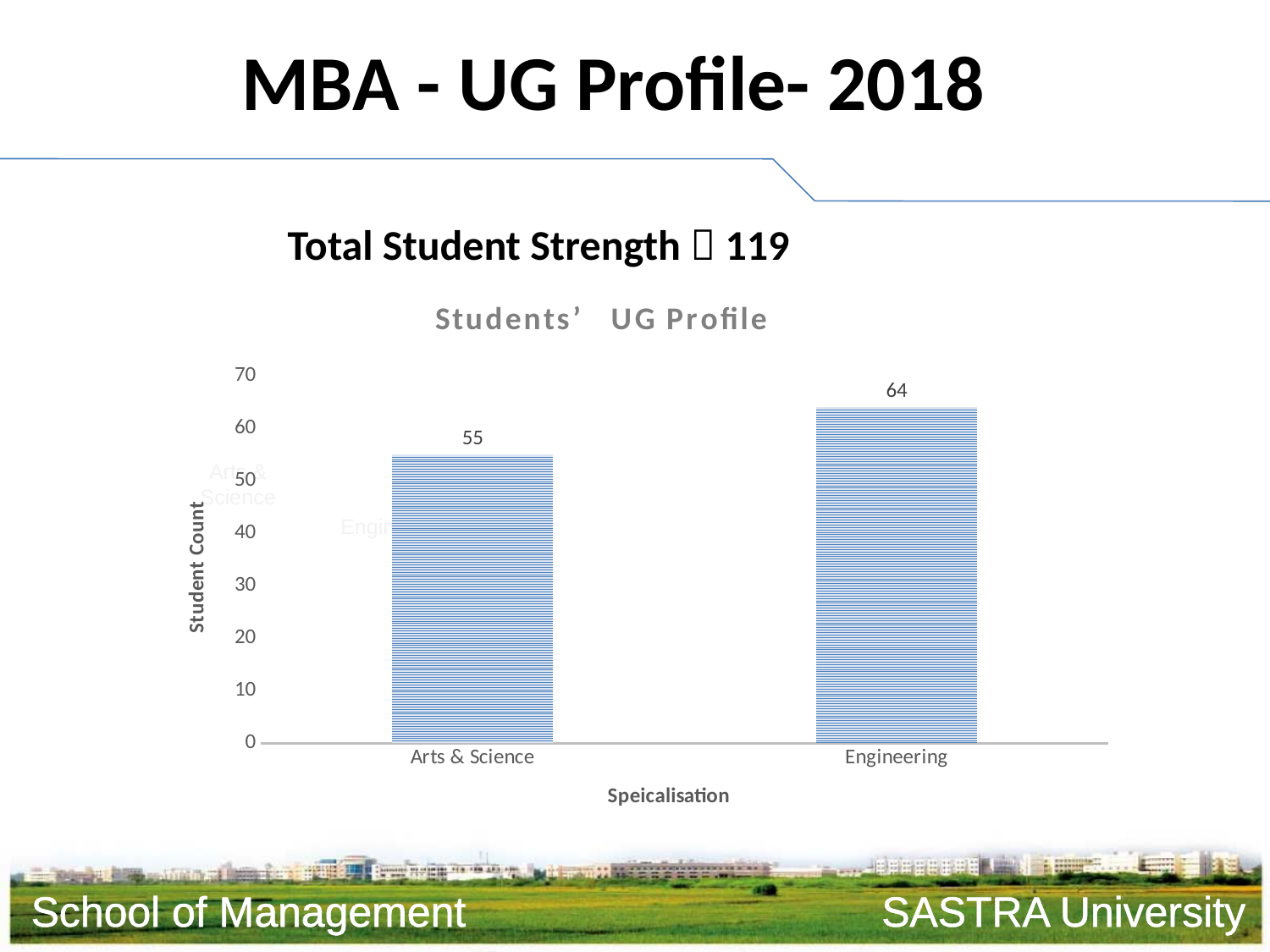
Which specialisation has the lowest student count? Arts & Science What is the title of the chart? Students' UG Profile Which has a larger student count, Arts & Science or Engineering? Engineering What is the student count for Arts & Science? 55 What kind of chart is shown on the slide? bar chart Is the value for Engineering greater or less than 60? greater What is the difference between the student counts for Engineering and Arts & Science? 9 How many specialisation categories are shown on the chart? 2 Which specialisation has the highest student count? Engineering What is the label of the vertical axis? Student Count What is the student count for Engineering? 64 Is the value for Arts & Science greater or less than 60? less